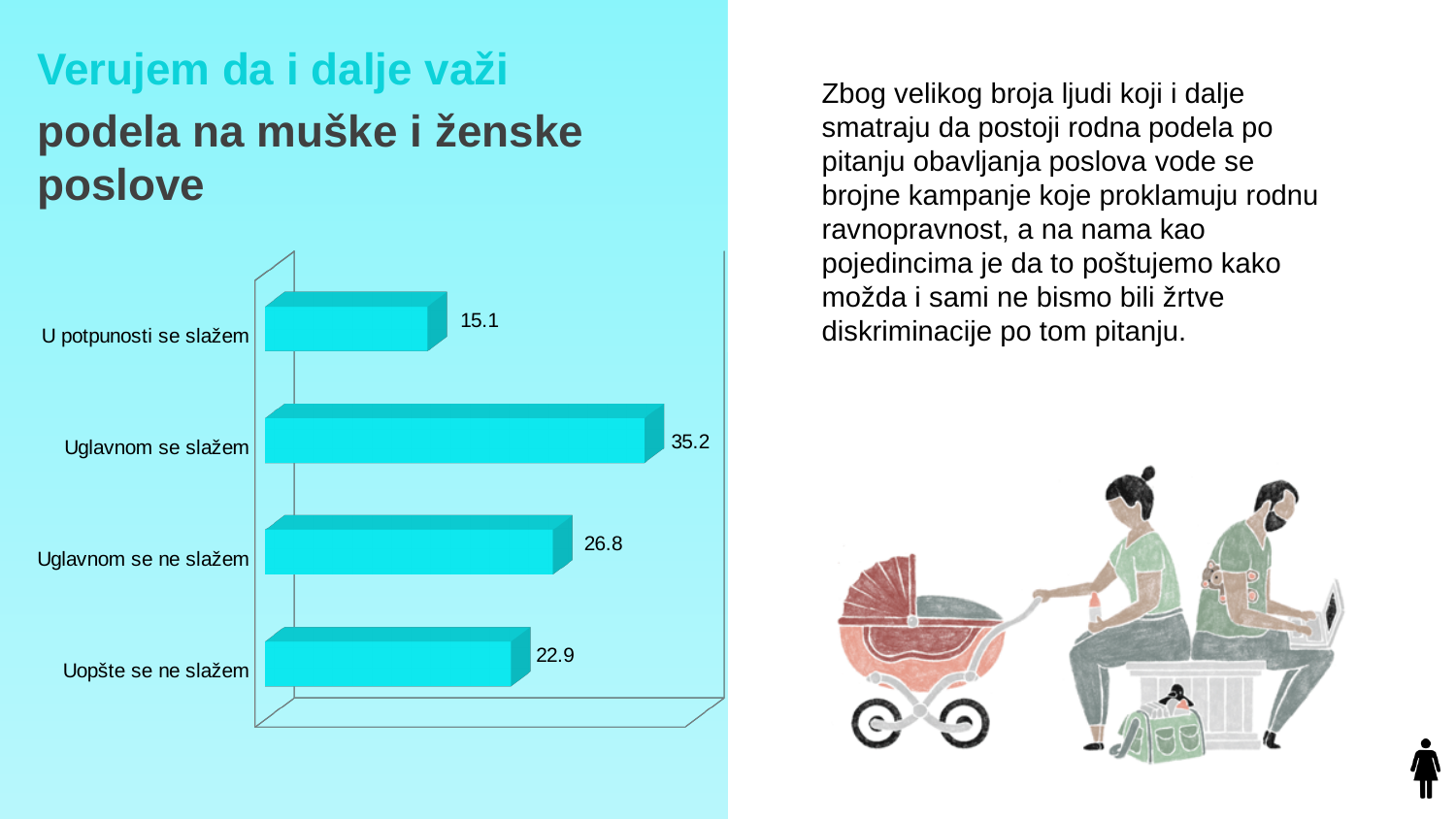
What colour are the bars in the chart? Cyan Which category has the lowest value? U potpunosti se slažem What is the value for "U potpunosti se slažem"? 15.1 What is the value for "Uglavnom se slažem"? 35.2 What is the difference between the values for "Uglavnom se slažem" and "U potpunosti se slažem"? 20.1 How many categories are shown in the chart? 4 What is the value for "Uglavnom se ne slažem"? 26.8 Which category has the highest value? Uglavnom se slažem What is the difference between the values for "Uglavnom se ne slažem" and "Uopšte se ne slažem"? 3.9 What kind of chart is shown on the slide? Bar chart Which is larger, the value for "Uglavnom se ne slažem" or the value for "Uopšte se ne slažem"? Uglavnom se ne slažem What is the value for "Uopšte se ne slažem"? 22.9